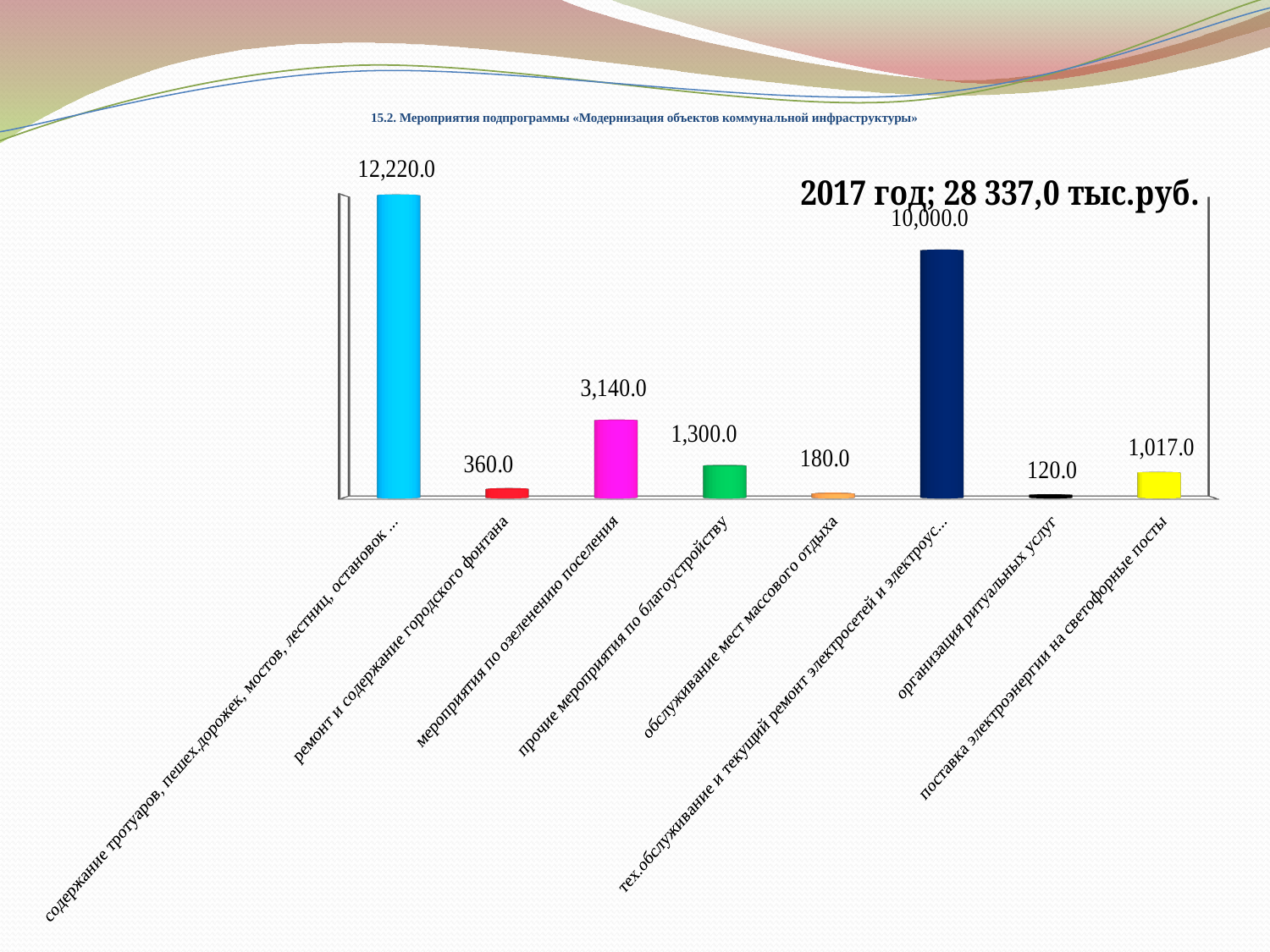
What is the difference between the two largest bars, 12,220.0 and 10,000.0? 2,220.0 What is the value for «ремонт и содержание городского фонтана»? 360.0 What is the difference between the values for «мероприятия по озеленению поселения» and «прочие мероприятия по благоустройству»? 1,840.0 Which category has the lowest value? организация ритуальных услуг What is the value for «обслуживание мест массового отдыха»? 180.0 What kind of chart is shown on the slide? bar chart Which category has the highest value? содержание тротуаров, пешех.дорожек, мостов, лестниц, остановок ... What is the value for «мероприятия по озеленению поселения»? 3,140.0 How many categories are shown in the chart? 8 What is the value for «поставка электроэнергии на светофорные посты»? 1,017.0 What year and total amount are stated in the chart's title text? 2017 год; 28 337,0 тыс.руб. Which is larger: the value for «ремонт и содержание городского фонтана» or for «обслуживание мест массового отдыха»? ремонт и содержание городского фонтана